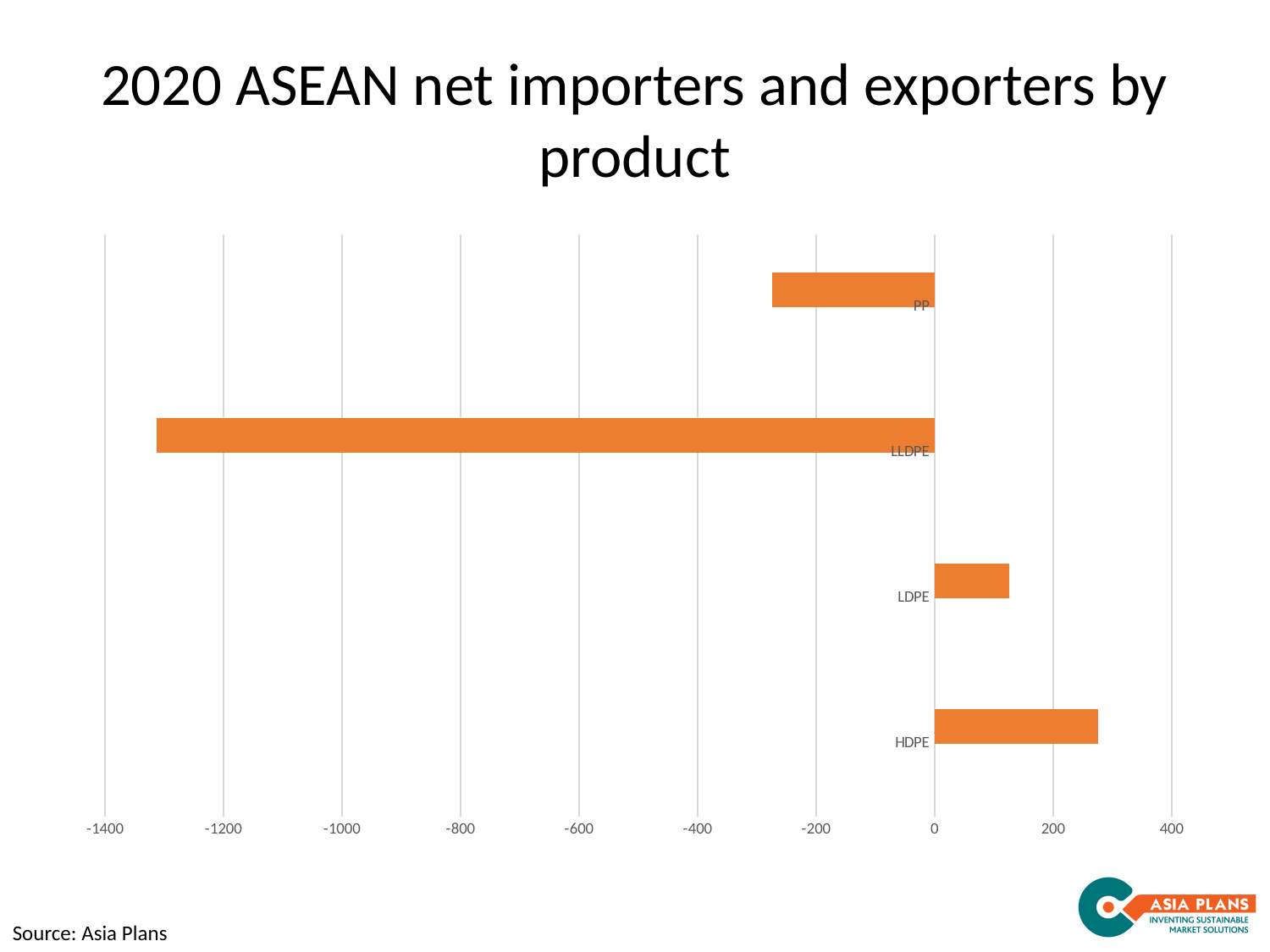
Is the value for PP greater or less than -200? less What kind of chart is shown on the slide? bar chart Which has the higher value, PP or LLDPE? PP Is the value for HDPE greater or less than 200? greater What is the title of the chart? 2020 ASEAN net importers and exporters by product Which product has the highest value in the chart? HDPE Which has the higher value, HDPE or LDPE? HDPE Is the value for LLDPE greater or less than -1200? less Which product has the lowest value in the chart? LLDPE How many products are shown in the chart? 4 What source is cited for the chart? Asia Plans